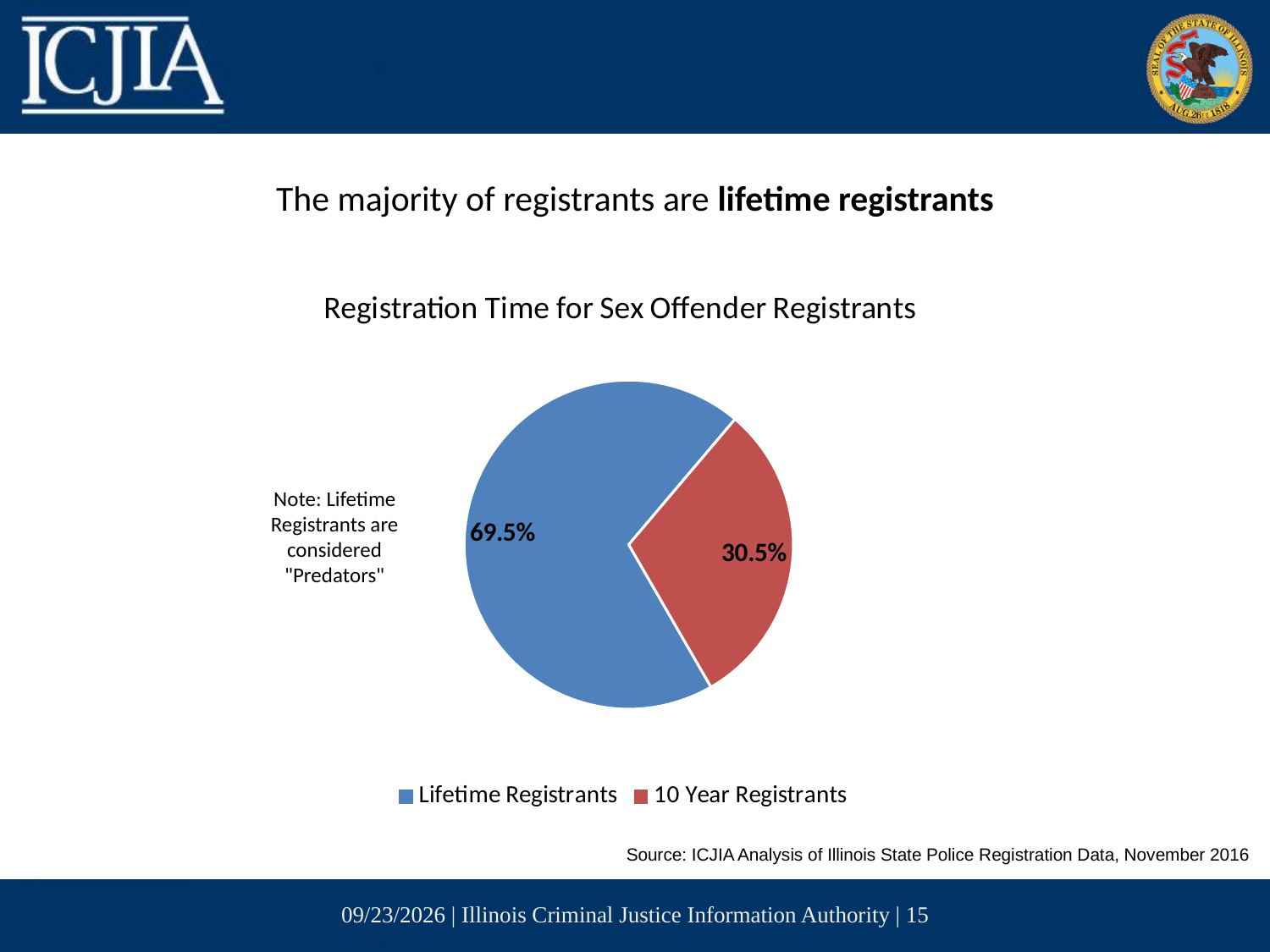
Which is larger: the share of Lifetime Registrants or the share of 10 Year Registrants? Lifetime Registrants What percentage of registrants are Lifetime Registrants? 69.5% How many entries does the legend list? 2 What type of chart is shown on the slide? Pie chart Which category has the largest share of the pie? Lifetime Registrants How many categories does the pie chart show? 2 Which category has the smallest share of the pie? 10 Year Registrants What is the title of the chart? Registration Time for Sex Offender Registrants What colour represents 10 Year Registrants in the pie chart? Red What percentage of registrants are 10 Year Registrants? 30.5% What is the difference in percentage points between Lifetime Registrants and 10 Year Registrants? 39 percentage points What share of the pie do Lifetime Registrants make up? 69.5%